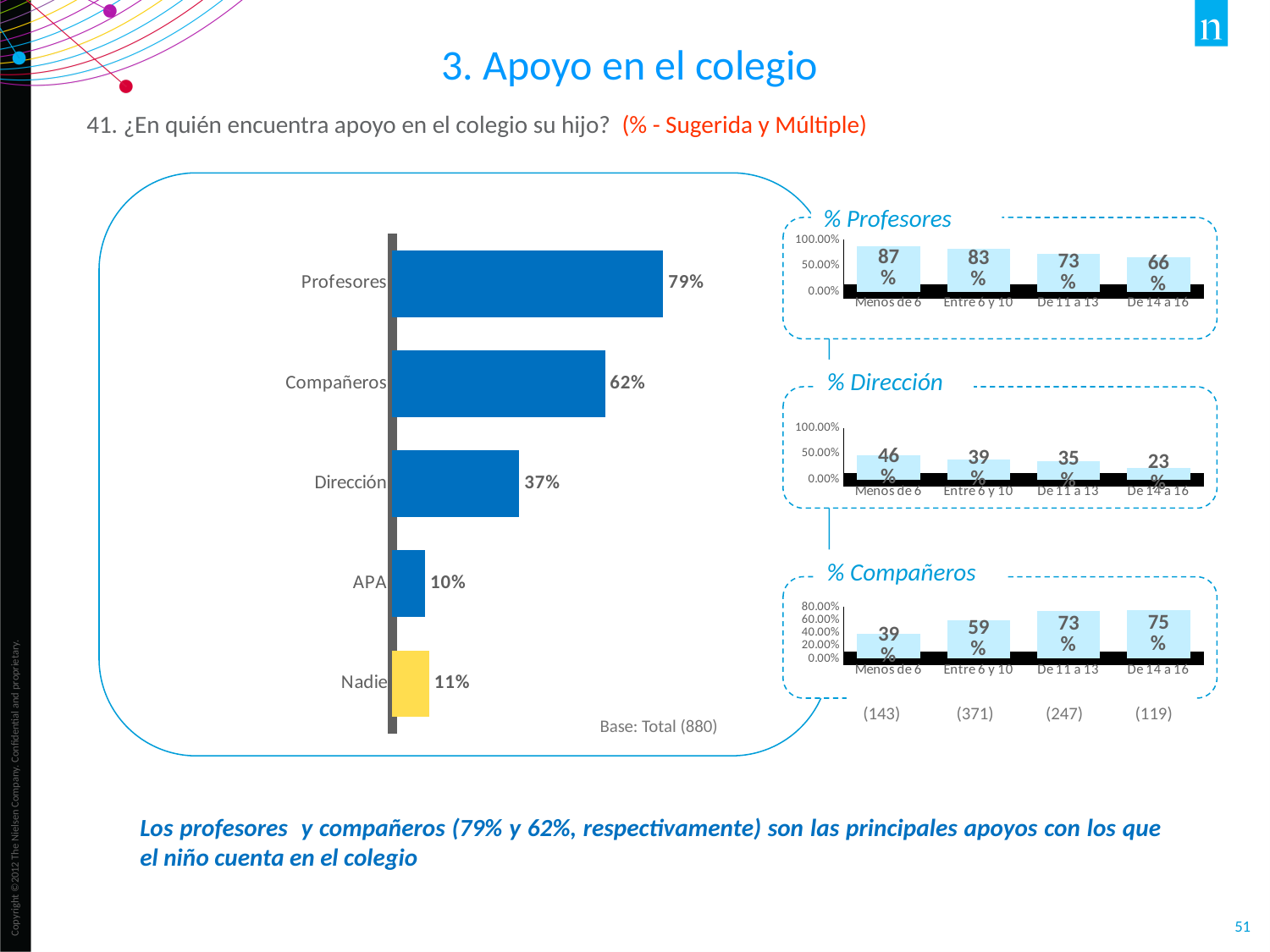
In the main bar chart on the left, which category has the lowest value? APA In the '% Dirección' chart, which age group has the highest value? Menos de 6 In the '% Profesores' chart, what is the value for De 14 a 16? 66% In the main bar chart on the left, what is the difference between Profesores and Compañeros? 17% In the '% Profesores' chart, do the values rise or fall from Menos de 6 to De 14 a 16? Fall How many categories does the main bar chart on the left show? 5 In the main bar chart on the left, which is larger, APA or Nadie? Nadie In the '% Compañeros' chart, what is the value for Entre 6 y 10? 59% In the main bar chart on the left, what is the value for Dirección? 37% What kind of chart is the main chart on the left? Bar chart In the main bar chart on the left, what is the value for Profesores? 79% In the '% Compañeros' chart, what is the difference between De 14 a 16 and Menos de 6? 36%